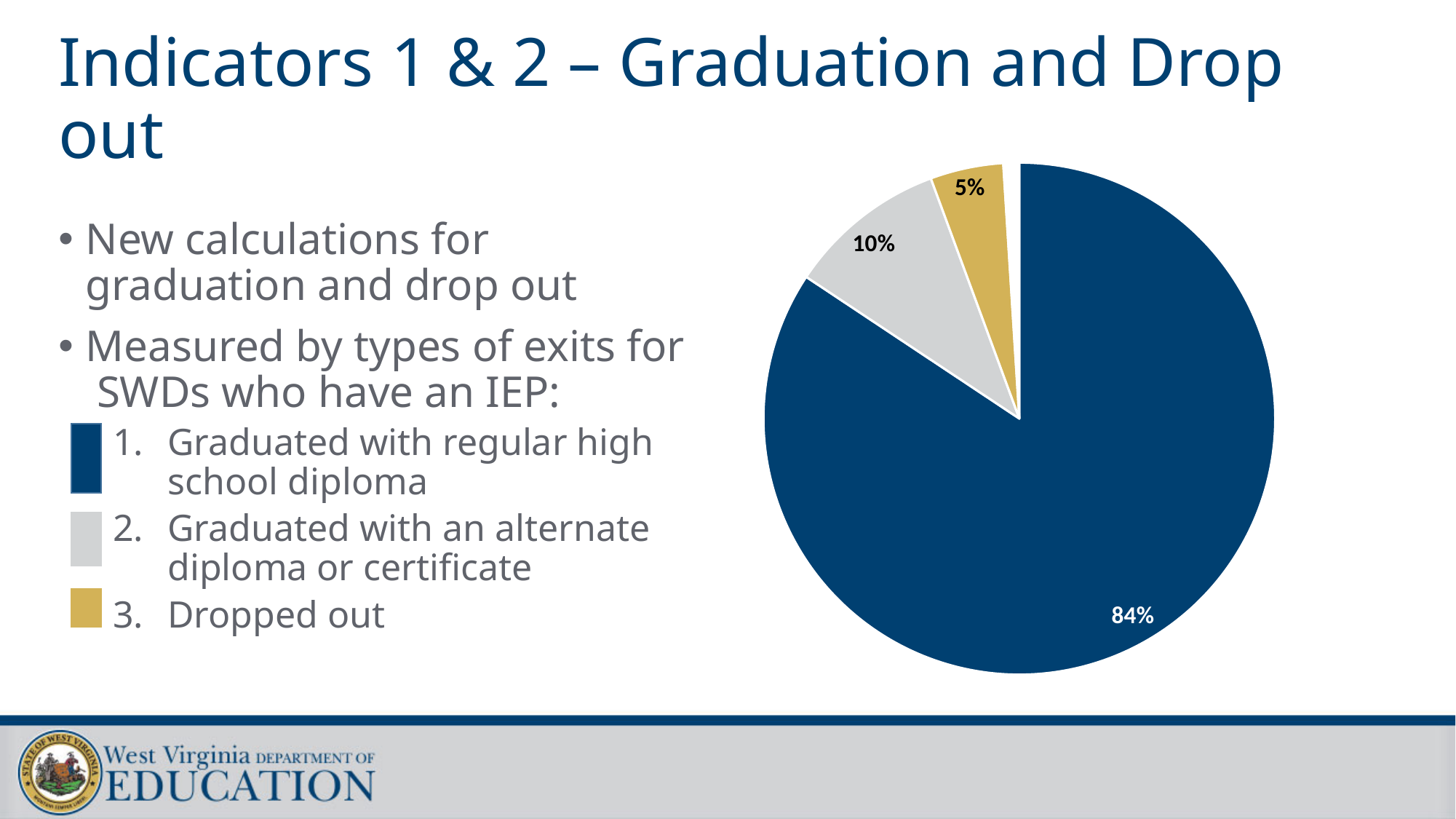
Which is larger: the slice for alternate diploma or certificate, or the slice for dropped out? Graduated with an alternate diploma or certificate Which exit type has the largest slice of the pie? Graduated with regular high school diploma What percentage of the pie is labelled for students who graduated with a regular high school diploma? 84% What is the difference in percentage points between the alternate diploma or certificate slice and the dropped out slice? 5 What kind of chart is shown on the slide? pie chart What percentage of the pie is labelled for students who graduated with an alternate diploma or certificate? 10% What percentage of the pie is labelled for students who dropped out? 5% What colour is the slice representing students who graduated with a regular high school diploma? dark blue What colour is the slice representing students who dropped out? gold What is the difference in percentage points between the regular high school diploma slice and the alternate diploma or certificate slice? 74